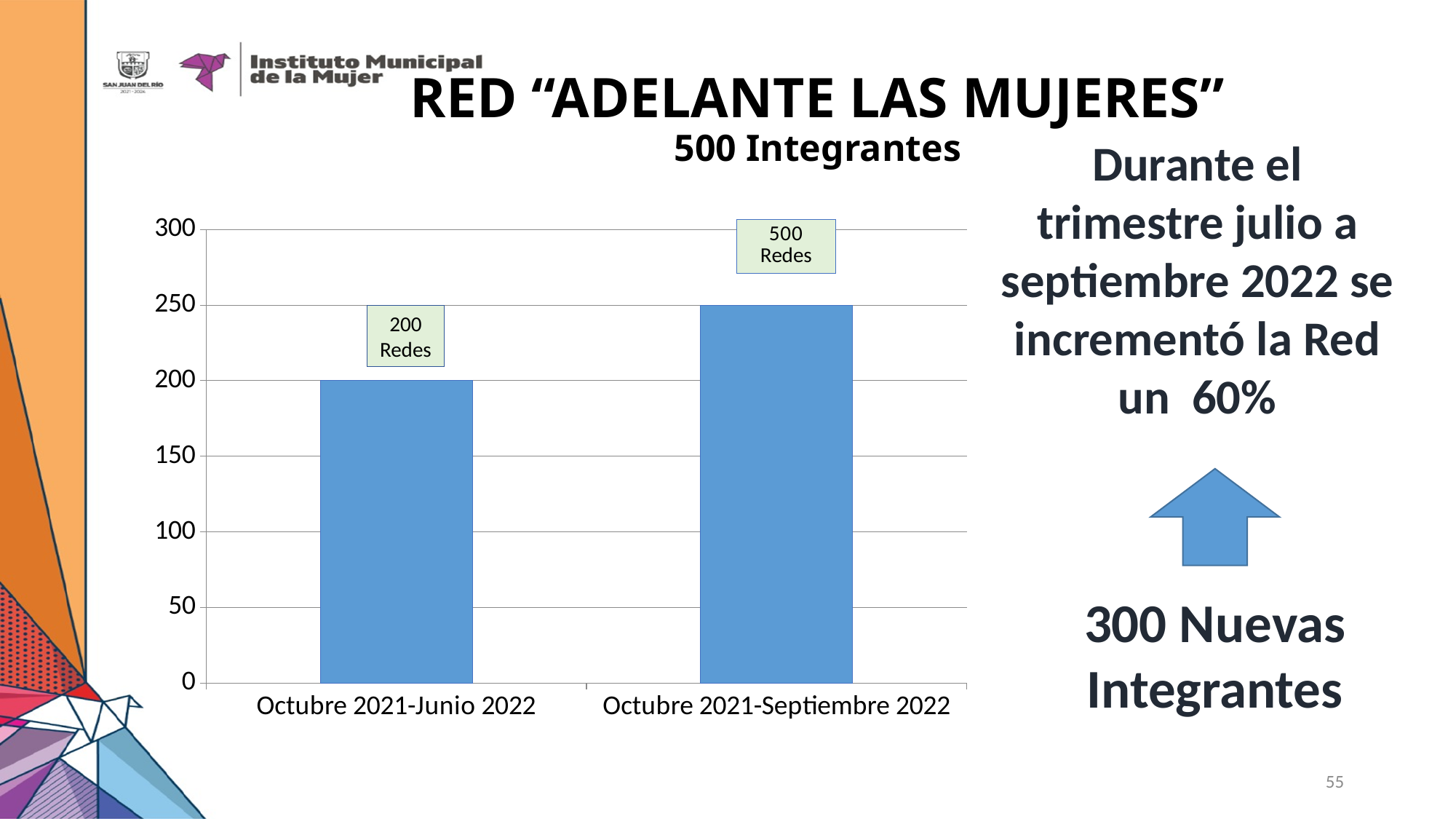
Is the bar for Octubre 2021-Septiembre 2022 taller or shorter than the bar for Octubre 2021-Junio 2022? taller What is the title of the chart? 500 Integrantes Do the bar values rise or fall from left to right? rise Which period has the shorter bar? Octubre 2021-Junio 2022 What is the highest value shown on the vertical axis? 300 How many bars does the chart have? 2 Is the bar for Octubre 2021-Septiembre 2022 greater or less than 200 on the axis? greater What value is labelled on the bar for Octubre 2021-Junio 2022? 200 Redes Is the bar for Octubre 2021-Junio 2022 greater or less than 250 on the axis? less Which period has the taller bar? Octubre 2021-Septiembre 2022 What text is in the label box above the bar for Octubre 2021-Septiembre 2022? 500 Redes What kind of chart is shown on the slide? bar chart